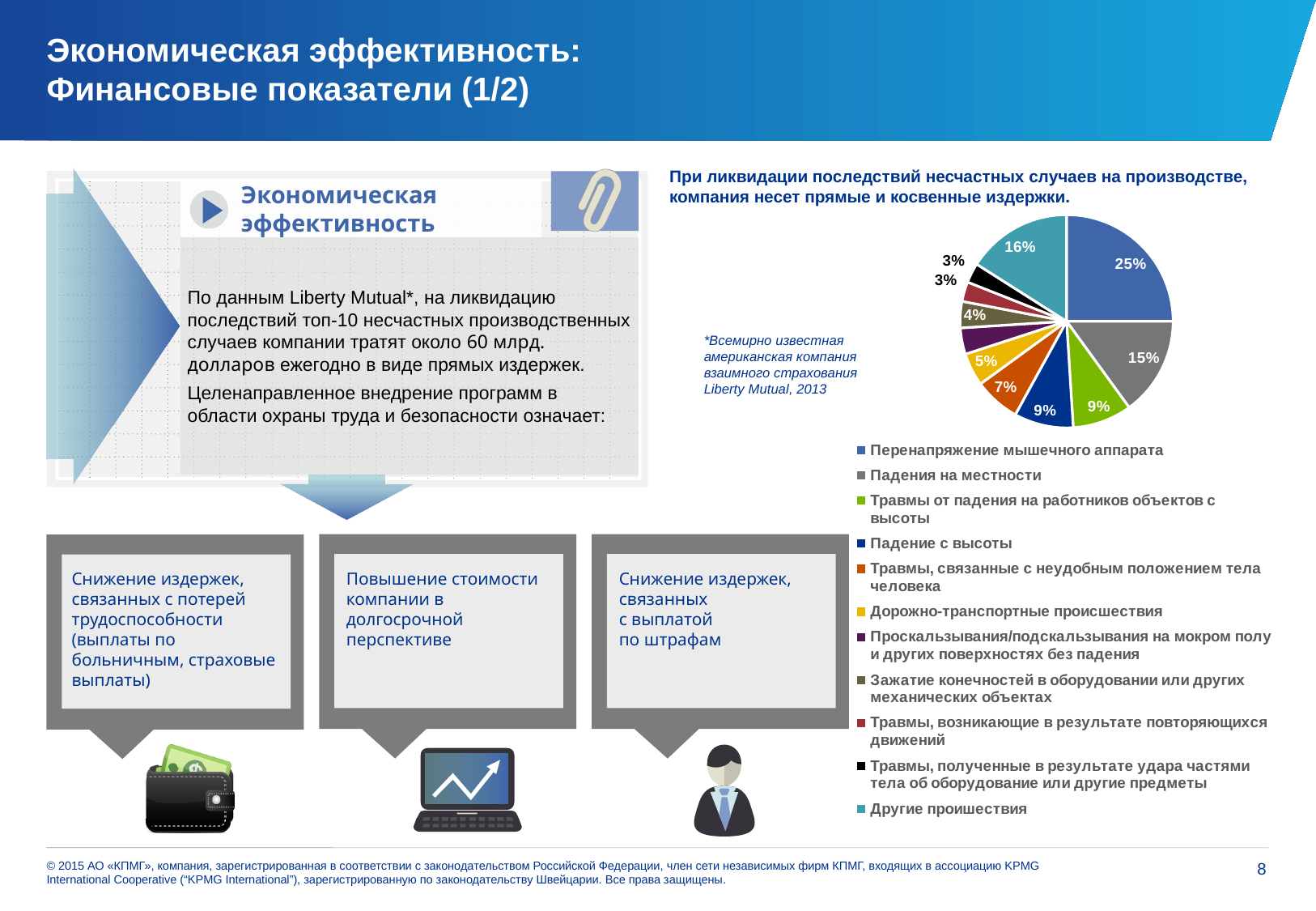
What colour is the slice for "Перенапряжение мышечного аппарата" in the pie chart? blue How many categories does the legend of the pie chart list? 11 What share of the pie chart is labelled for "Перенапряжение мышечного аппарата"? 25% What share of the pie chart is labelled for "Другие происшествия"? 16% What share of the pie chart is labelled for "Проскальзывания/подскальзывания на мокром полу и других поверхностях без падения"? 4% What kind of chart is shown on the slide? pie chart What share of the pie chart is labelled for "Травмы, связанные с неудобным положением тела человека"? 7% What share of the pie chart is labelled for "Дорожно-транспортные происшествия"? 5% Which category has the largest slice in the pie chart? Перенапряжение мышечного аппарата Which slice is larger: "Другие происшествия" or "Падения на местности"? Другие происшествия What is the difference in percentage points between the slices for "Перенапряжение мышечного аппарата" and "Падения на местности"? 10 percentage points What share of the pie chart is labelled for "Падения на местности"? 15%